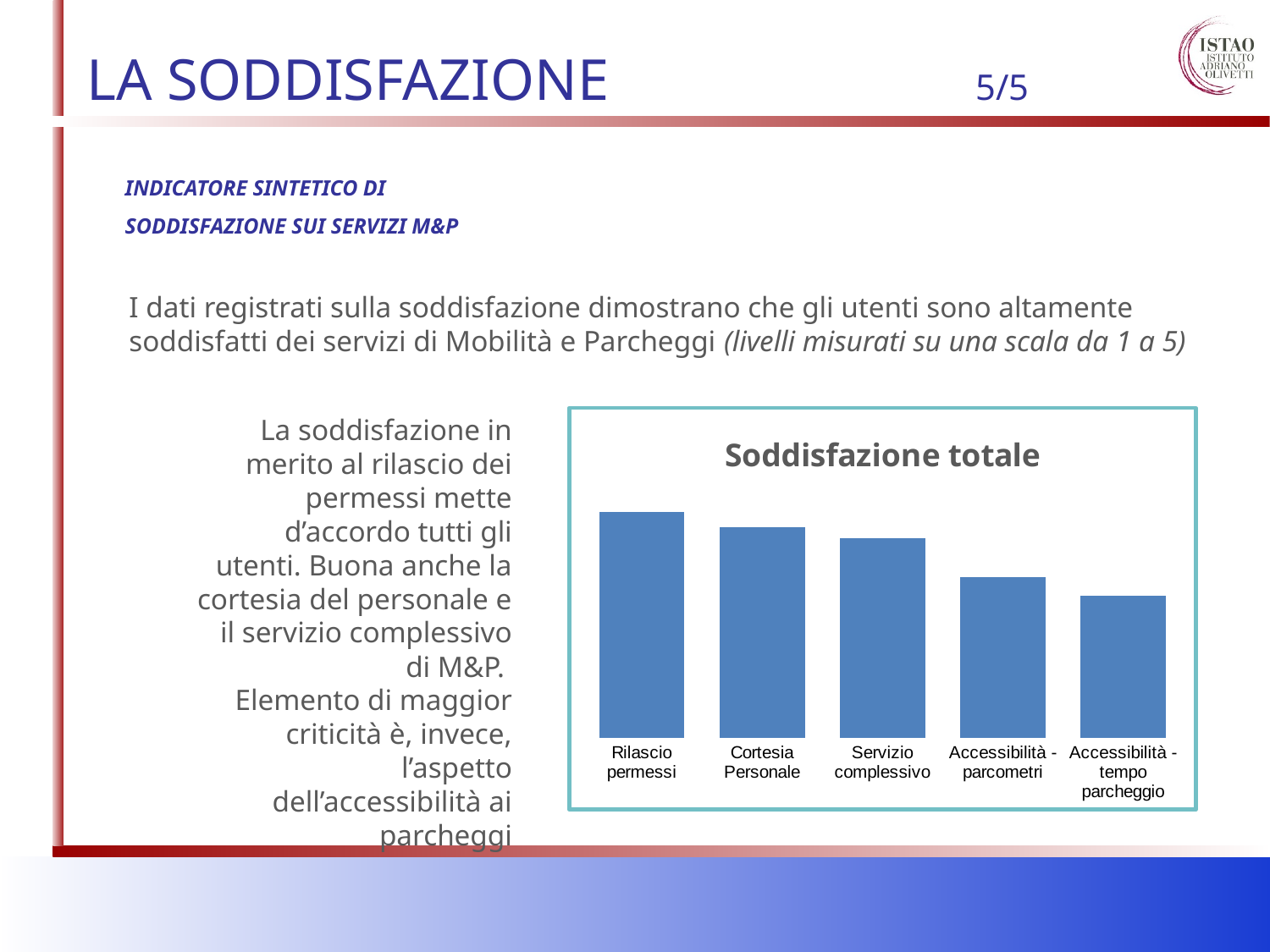
What is the title of the chart? Soddisfazione totale What kind of chart is shown on the slide? bar chart Which is larger, the value for Cortesia Personale or the value for Accessibilità - tempo parcheggio? Cortesia Personale What colour are the bars in the chart? blue Which category has the highest value in the chart? Rilascio permessi Which category is plotted third from the left in the chart? Servizio complessivo Which is larger, the value for Rilascio permessi or the value for Accessibilità - tempo parcheggio? Rilascio permessi Which category has the lowest value in the chart? Accessibilità - tempo parcheggio Which is larger, the value for Servizio complessivo or the value for Accessibilità - parcometri? Servizio complessivo Do the values rise or fall from left to right along the x axis? fall How many categories are shown in the chart? 5